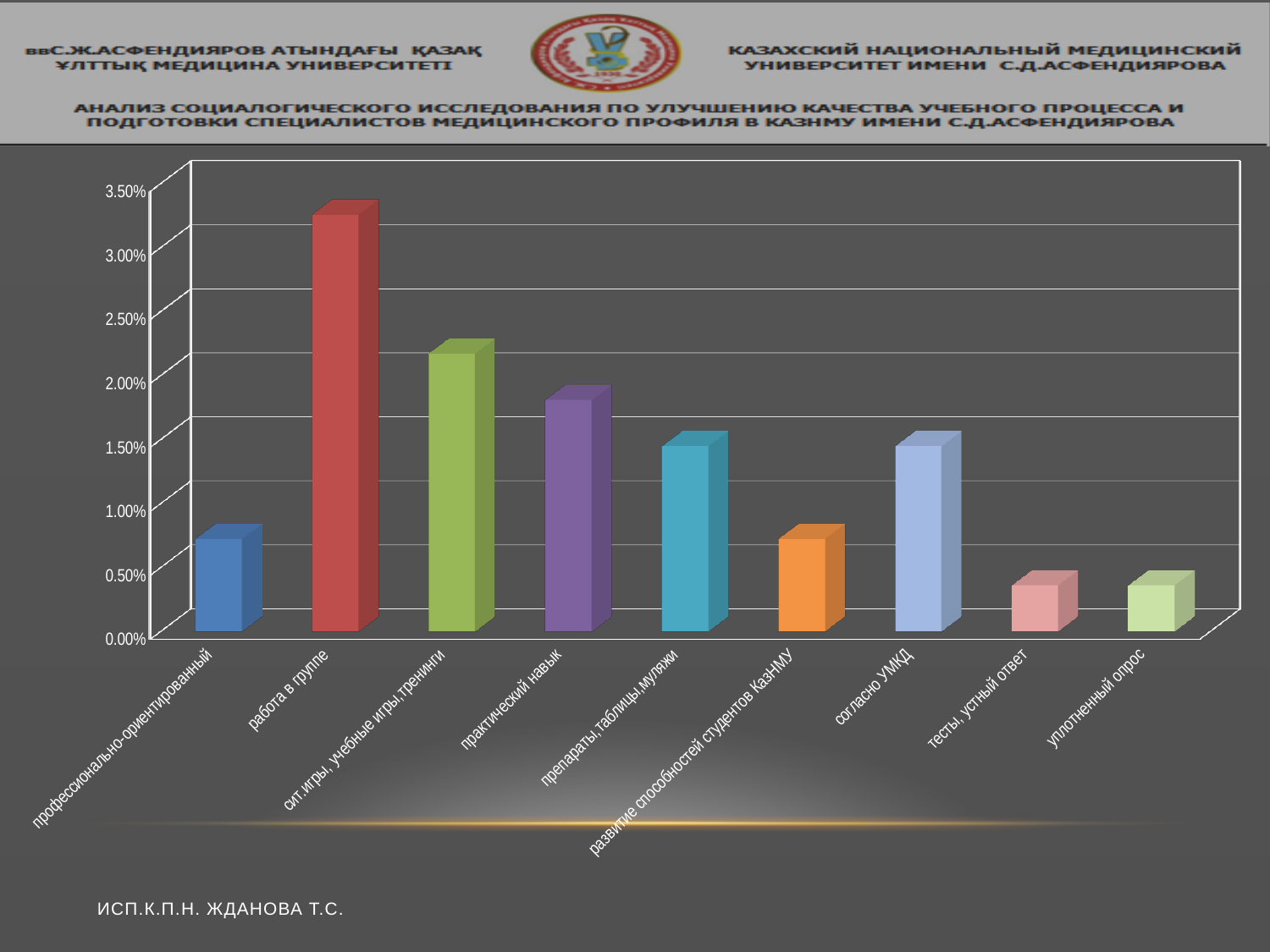
How many categories are plotted on the x axis of the chart? 9 Is the value for согласно УМКД greater or less than 1.00%? greater Is the value for работа в группе greater or less than 3.00%? greater Is the value for тесты, устный ответ greater or less than 0.50%? less Which is larger, the value for практический навык or the value for препараты, таблицы,муляжи? практический навык Which category has the highest bar in the chart? работа в группе What is the highest value shown on the y axis of the chart? 3.50% Which is larger, the value for работа в группе or the value for сит.игры, учебные игры,тренинги? работа в группе What kind of chart is shown on the slide? bar chart